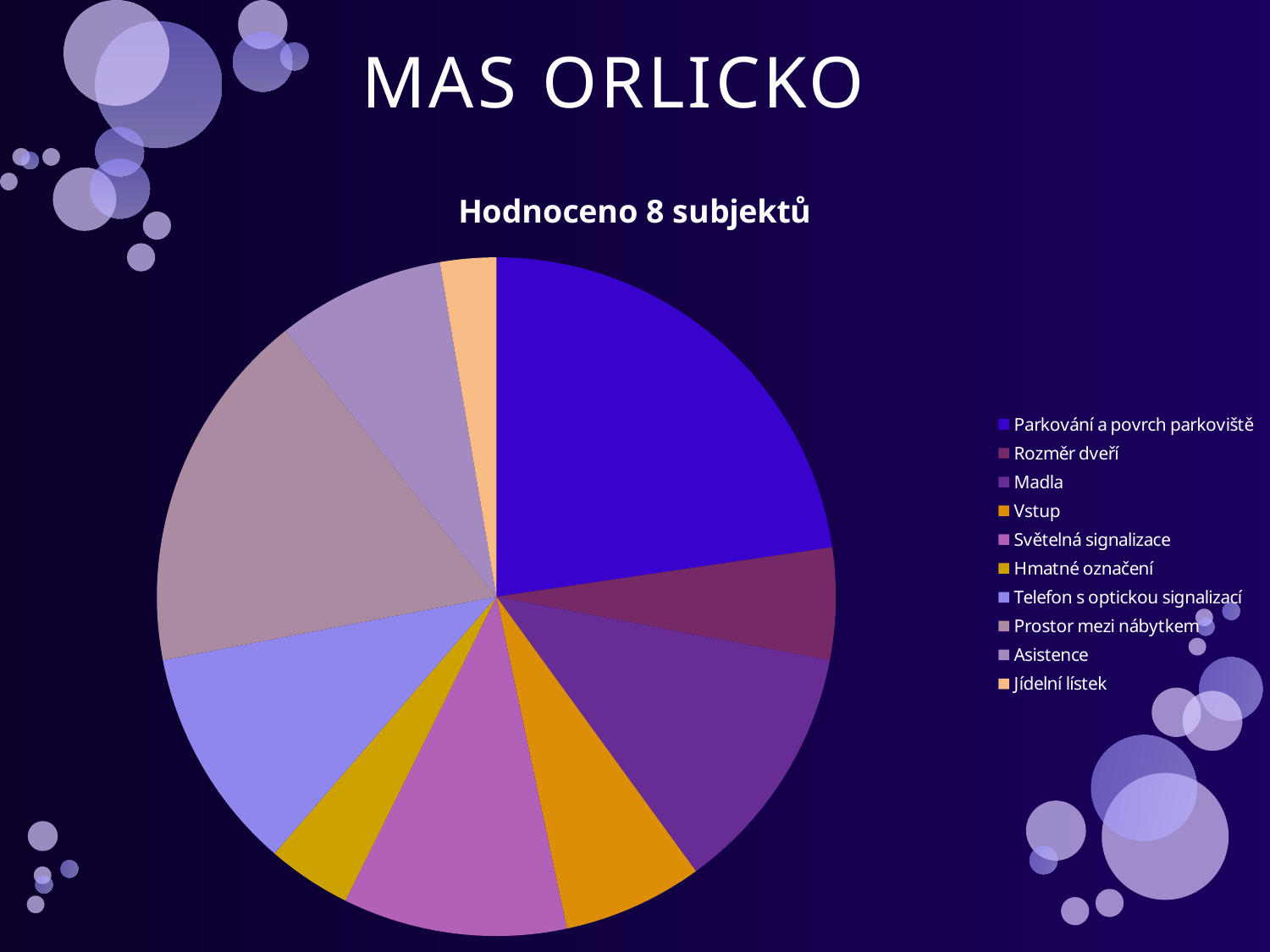
Which slice is larger, Prostor mezi nábytkem or Madla? Prostor mezi nábytkem Which category has the largest slice of the pie? Parkování a povrch parkoviště Which slice is larger, Parkování a povrch parkoviště or Prostor mezi nábytkem? Parkování a povrch parkoviště Which slice is larger, Světelná signalizace or Rozměr dveří? Světelná signalizace Which category has the smallest slice of the pie? Jídelní lístek What kind of chart is shown on the slide? pie chart Which legend entry is listed last in the chart legend? Jídelní lístek How many categories (slices) does the pie chart have? 10 What is the title of the chart? Hodnoceno 8 subjektů